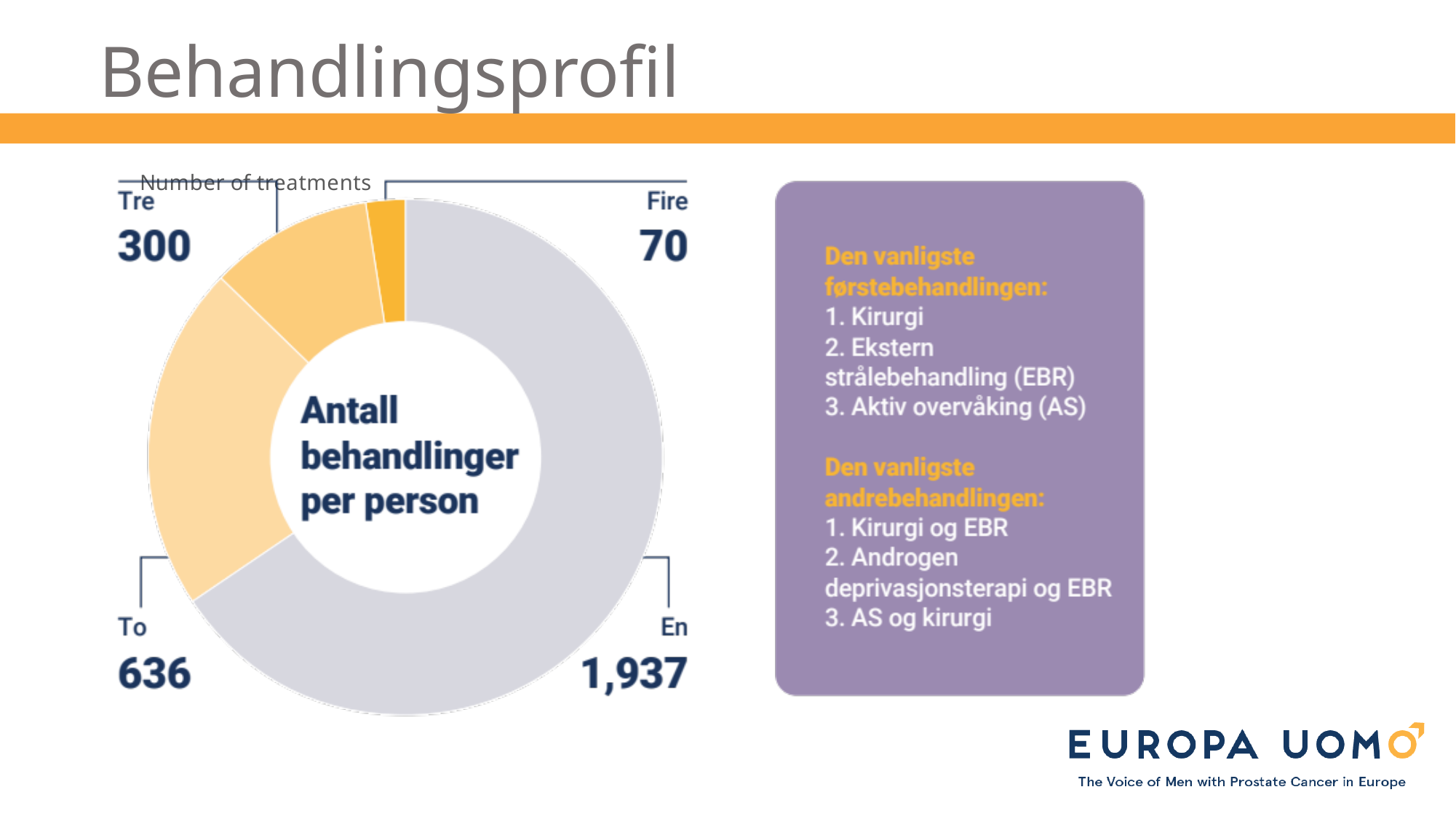
How many categories are shown in the donut chart? 4 Which category has the largest slice in the donut chart? En Which category has the smallest slice in the donut chart? Fire What kind of chart is shown on the slide? Pie chart (donut) What text is written in the centre of the donut chart? Antall behandlinger per person What is the value for the 'En' slice in the donut chart? 1,937 What is the difference between the values for 'En' and 'To'? 1,301 What is the difference between the values for 'Tre' and 'Fire'? 230 What is the value for the 'Fire' slice in the donut chart? 70 What is the value for the 'Tre' slice in the donut chart? 300 Which is larger, the value for 'To' or the value for 'Tre'? To What is the value for the 'To' slice in the donut chart? 636